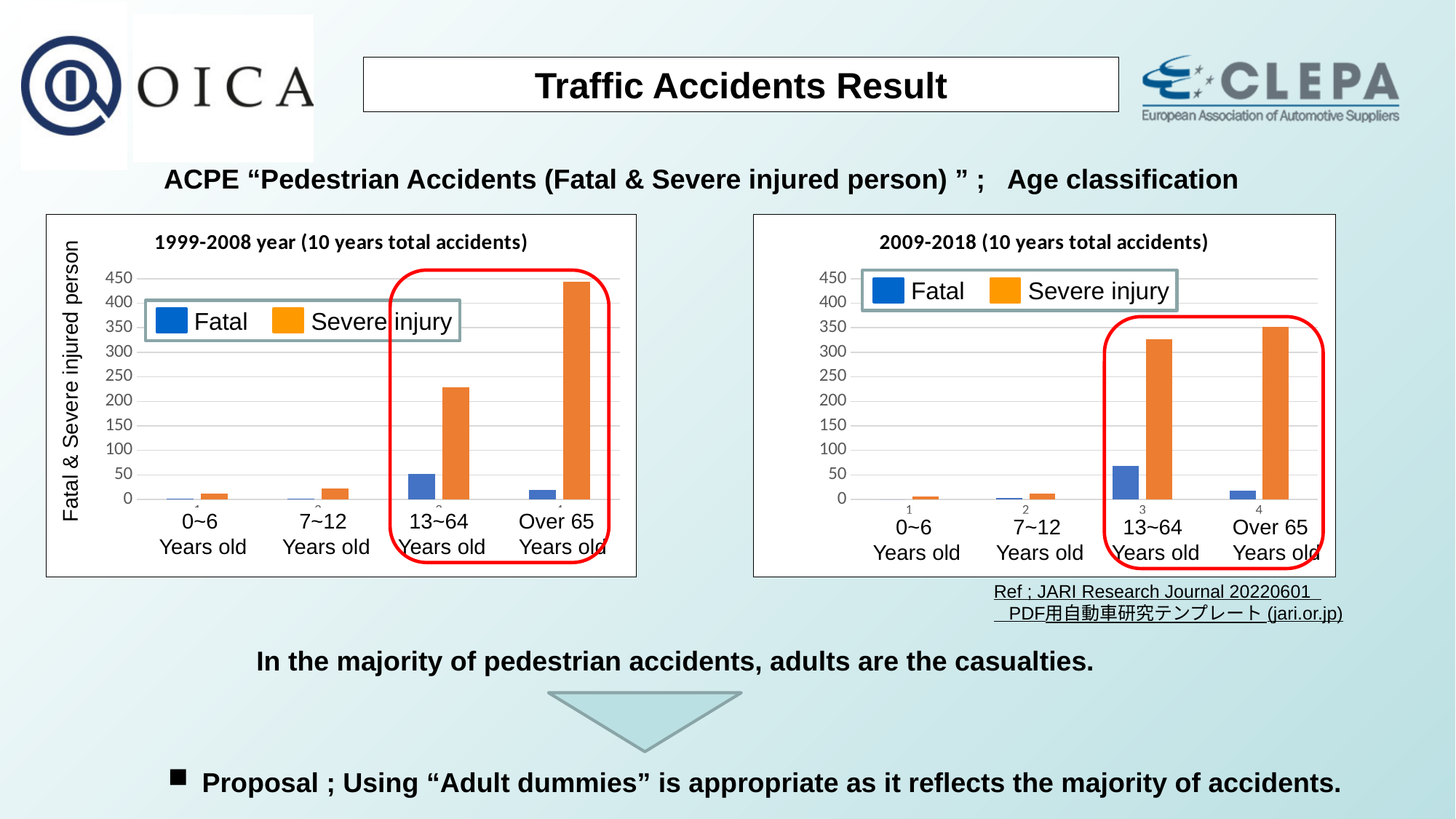
In the 1999-2008 chart, is the Severe injury value for Over 65 Years old greater or less than 400? greater In the 1999-2008 chart, is the Severe injury value for 13~64 Years old greater or less than 250? less In the 1999-2008 chart, which age group has the highest Severe injury value? Over 65 Years old In the 2009-2018 chart, is the Severe injury value for 13~64 Years old greater or less than 300? greater What kind of chart is the 2009-2018 chart? bar chart In the 2009-2018 chart, which age group has the highest Fatal value? 13~64 Years old How many series does the legend of the 1999-2008 chart list? 2 In the 1999-2008 chart, which age group has the lowest Severe injury value? 0~6 Years old How many age groups are shown on the x axis of the 2009-2018 chart? 4 In the 1999-2008 chart, which has the larger Fatal value: 13~64 Years old or Over 65 Years old? 13~64 Years old